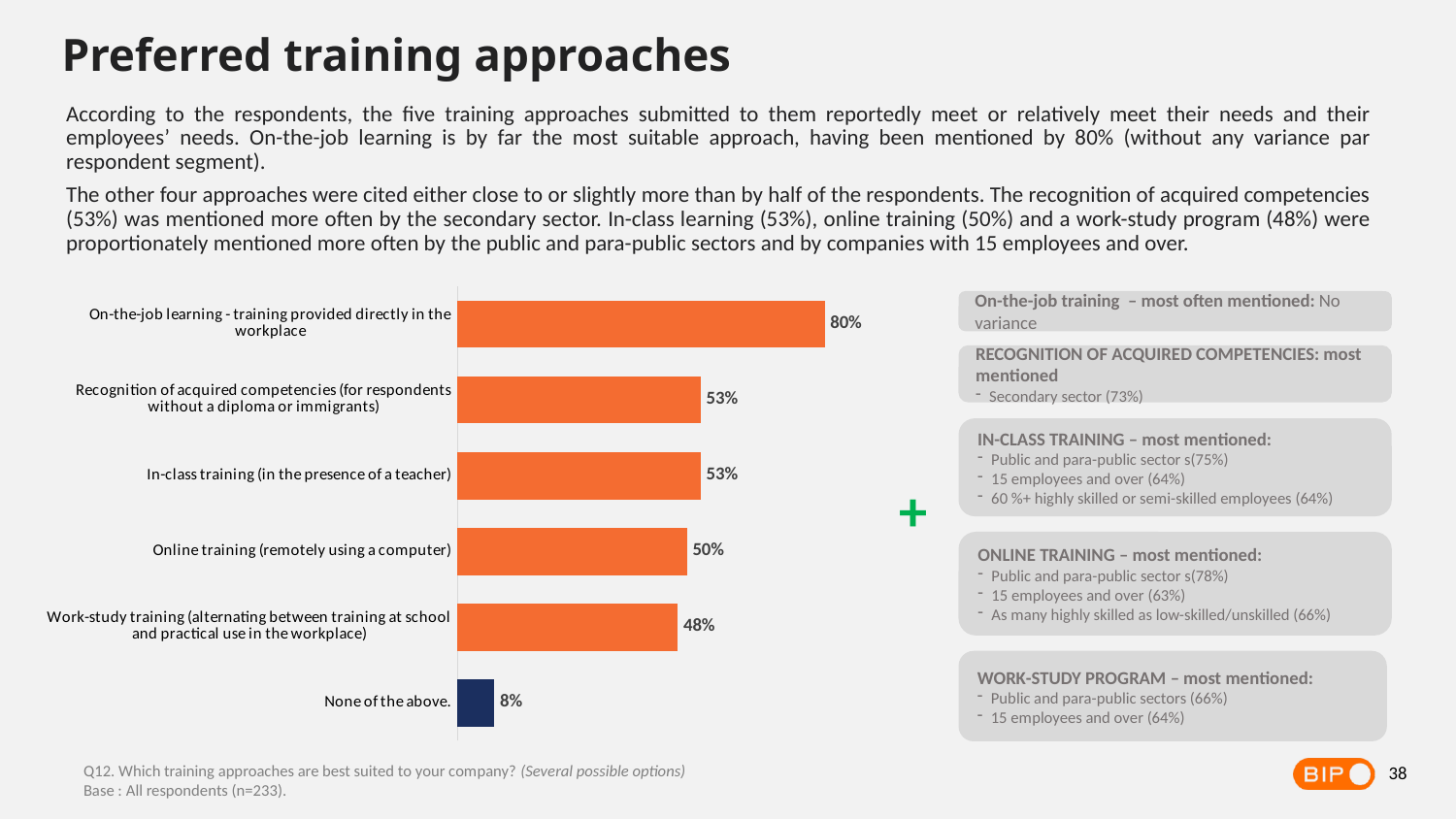
What type of chart is shown on the slide? Bar chart How many categories are shown in the chart? 6 What percentage is shown for work-study training (alternating between training at school and practical use in the workplace)? 48% What is the value for 'None of the above'? 8% What is the difference between the value for in-class training and the value for online training? 3% Which training approach has the highest percentage in the chart? On-the-job learning - training provided directly in the workplace What percentage of respondents mentioned on-the-job learning (training provided directly in the workplace)? 80% What is the difference between the value for on-the-job learning and the value for work-study training? 32% Which category has the lowest value in the chart? None of the above. What is the value shown for online training (remotely using a computer)? 50% Which is larger: the value for recognition of acquired competencies or the value for work-study training? Recognition of acquired competencies Which bar in the chart is coloured dark blue rather than orange? None of the above.